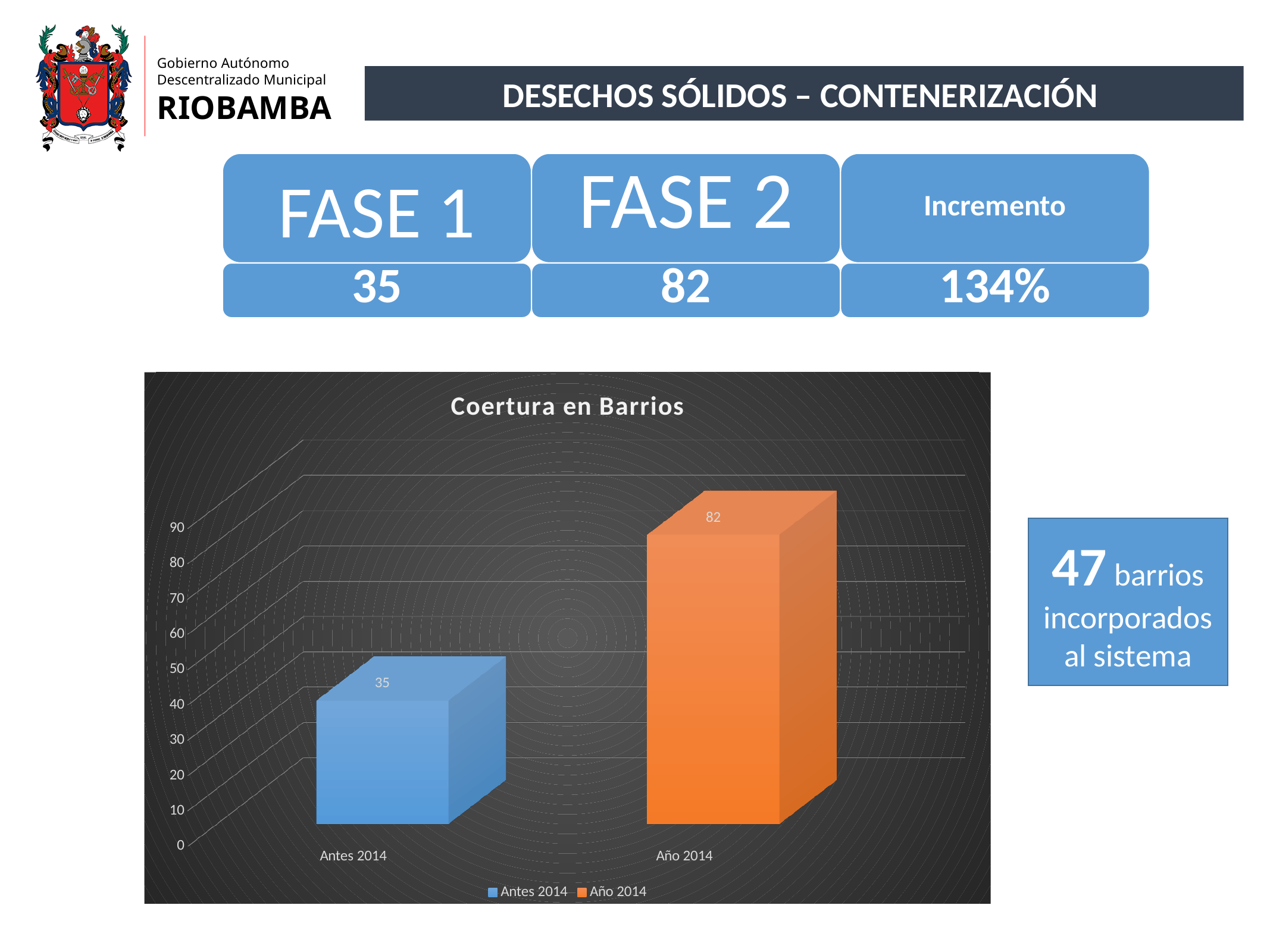
Is the value for Año 2014 greater or less than 70? greater What is the difference between the values for Año 2014 and Antes 2014? 47 What is the title of the chart? Coertura en Barrios Which category has the lowest value in the chart? Antes 2014 What is the value for Antes 2014 in the chart? 35 Is the value for Antes 2014 greater or less than 50? less What kind of chart is shown on the slide? Bar chart What is the value for Año 2014 in the chart? 82 Which category has the highest value in the chart? Año 2014 Which is larger, the value for Antes 2014 or the value for Año 2014? Año 2014 How many entries does the chart legend list? 2 How many categories are shown on the x axis of the chart? 2